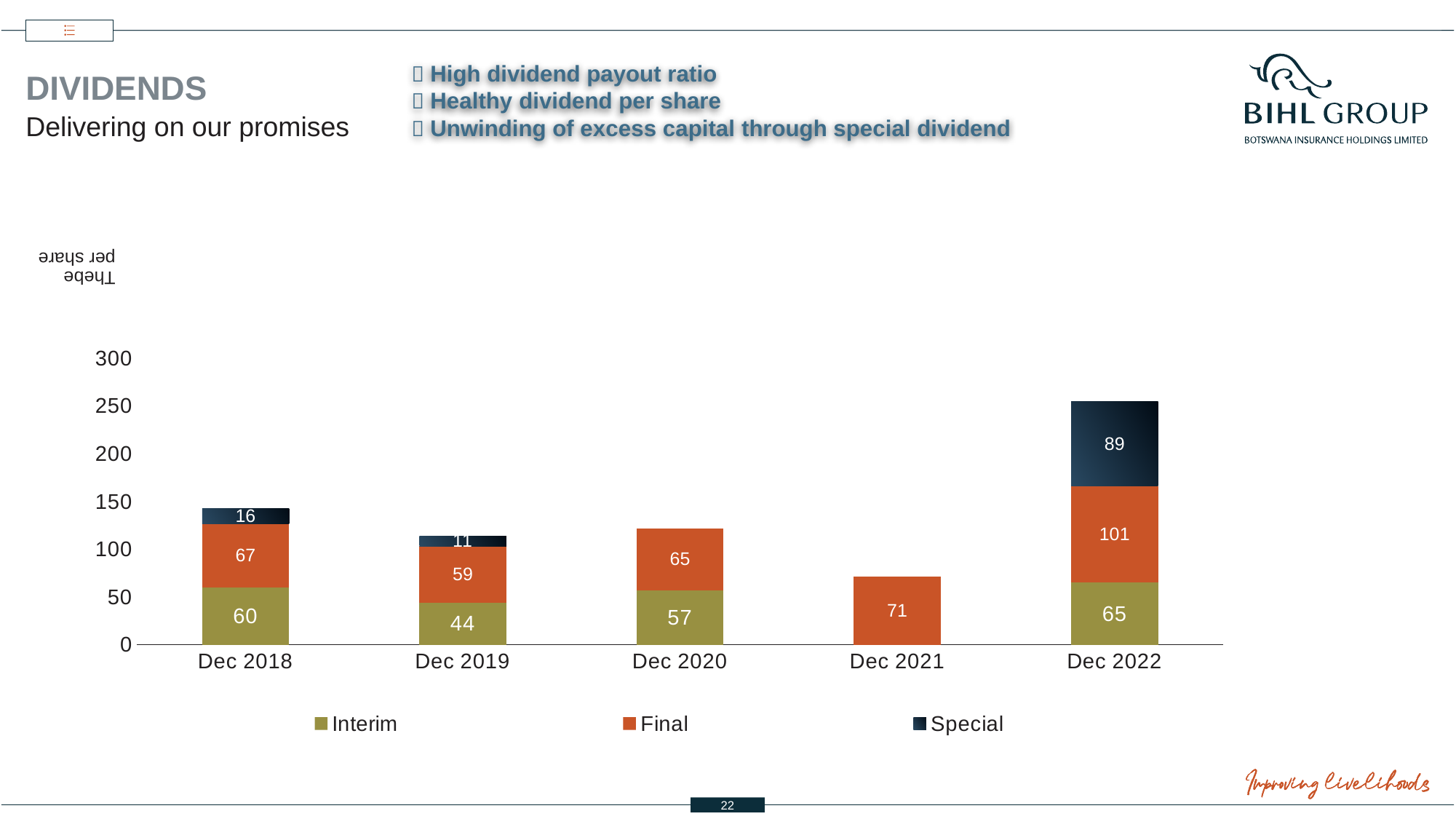
What is the Final dividend value for Dec 2022? 101 What is the difference between the Final dividend in Dec 2022 and the Final dividend in Dec 2021? 30 What is the label on the y axis? Thebe per share How many categories are shown on the x axis? 5 How many series does the legend list? 3 Which is larger, the Interim dividend for Dec 2018 or the Interim dividend for Dec 2020? Dec 2018 What kind of chart is shown on the slide? Stacked bar chart Which year has the highest total dividend per share? Dec 2022 What is the total of the stacked bar for Dec 2022? 255 Which year has the lowest total dividend per share? Dec 2021 What is the Special dividend value for Dec 2018? 16 What is the Interim dividend value for Dec 2019? 44